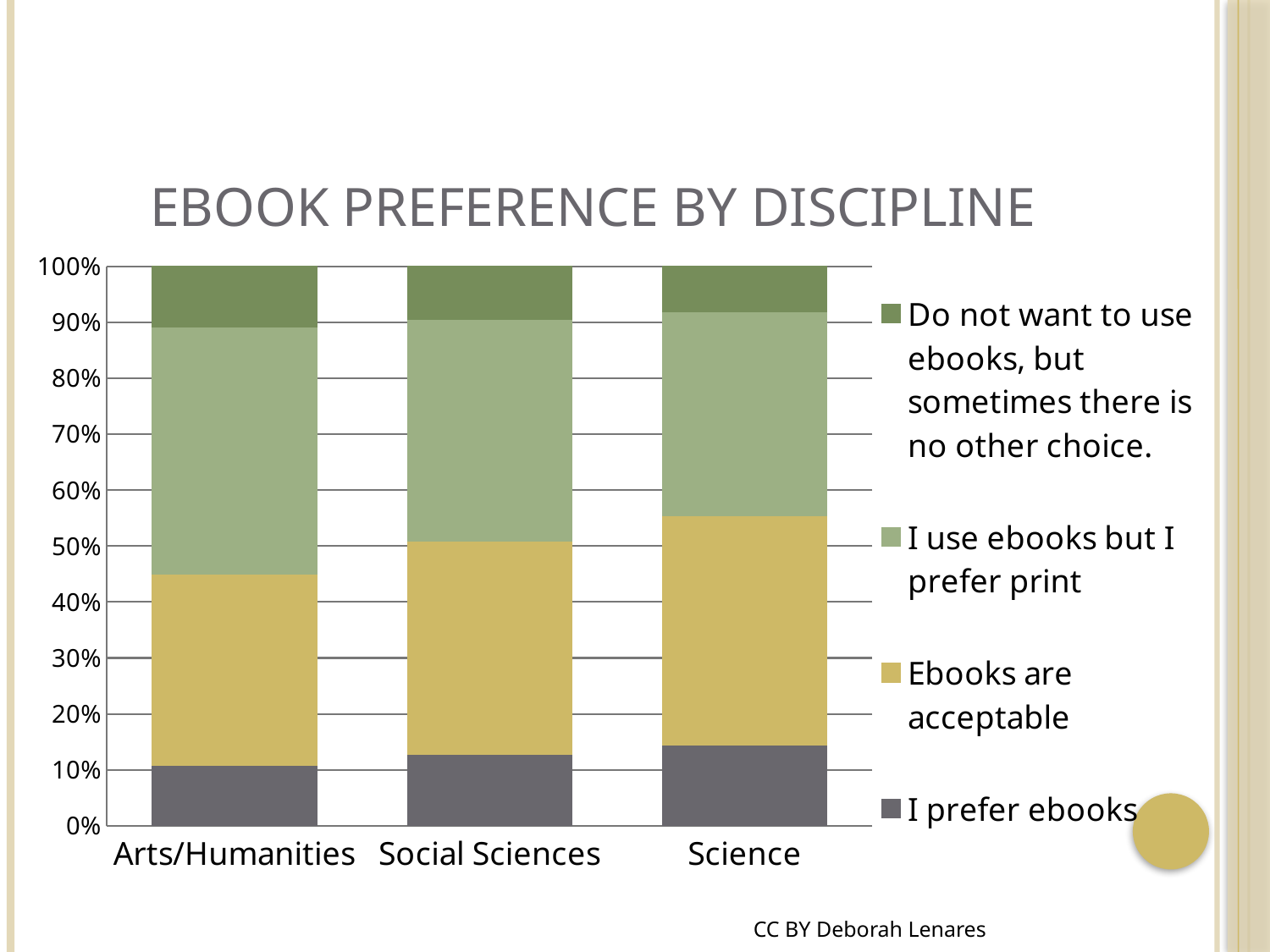
Is the 'I prefer ebooks' segment for Science greater or less than 10%? greater Which legend entry is shown in dark grey? I prefer ebooks Which discipline has the smallest 'I use ebooks but I prefer print' segment? Science How many disciplines are shown on the x axis of the chart? 3 Which is larger: the 'I prefer ebooks' segment for Science or for Arts/Humanities? Science Is the 'Ebooks are acceptable' segment for Science greater or less than 30%? greater Is the 'I prefer ebooks' segment for Arts/Humanities greater or less than 20%? less Which discipline has the largest 'Do not want to use ebooks, but sometimes there is no other choice.' segment? Arts/Humanities Which discipline has the largest 'I prefer ebooks' segment? Science How many series does the chart's legend list? 4 What is the title of the chart? EBOOK PREFERENCE BY DISCIPLINE What kind of chart is shown on the slide? Stacked bar chart